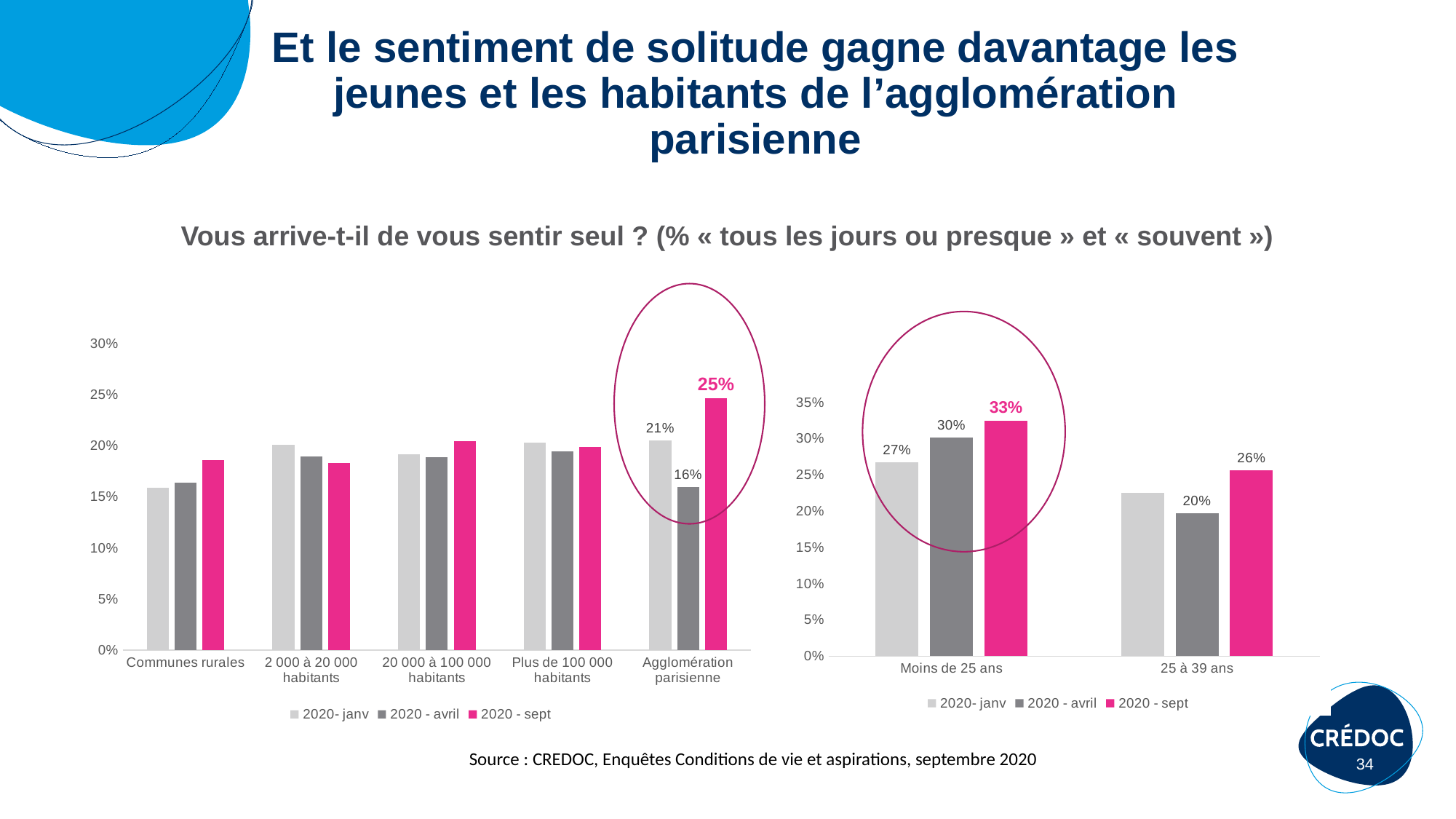
In the left chart (by commune size), what is the difference between the 2020 - sept and 2020 - avril values for Agglomération parisienne? 9 percentage points In the right chart (by age), what is the difference between the 2020 - sept values for Moins de 25 ans and 25 à 39 ans? 7 percentage points How many categories are shown on the x axis of the left chart (by commune size)? 5 In the left chart (by commune size), what is the value for Agglomération parisienne in 2020- janv? 21% How many series does the legend of the right chart (by age) list? 3 What kind of chart is the left chart (by commune size)? Bar chart In the left chart (by commune size), what is the value for Agglomération parisienne in 2020 - avril? 16% In the right chart (by age), what is the value for Moins de 25 ans in 2020 - sept? 33% In the right chart (by age), which is larger for Moins de 25 ans: the 2020- janv value or the 2020 - avril value? 2020 - avril In the right chart (by age), what is the value for 25 à 39 ans in 2020 - avril? 20% In the left chart (by commune size), is the 2020 - sept value for Communes rurales greater or less than 20%? less In the left chart (by commune size), what is the value for Agglomération parisienne in 2020 - sept? 25%